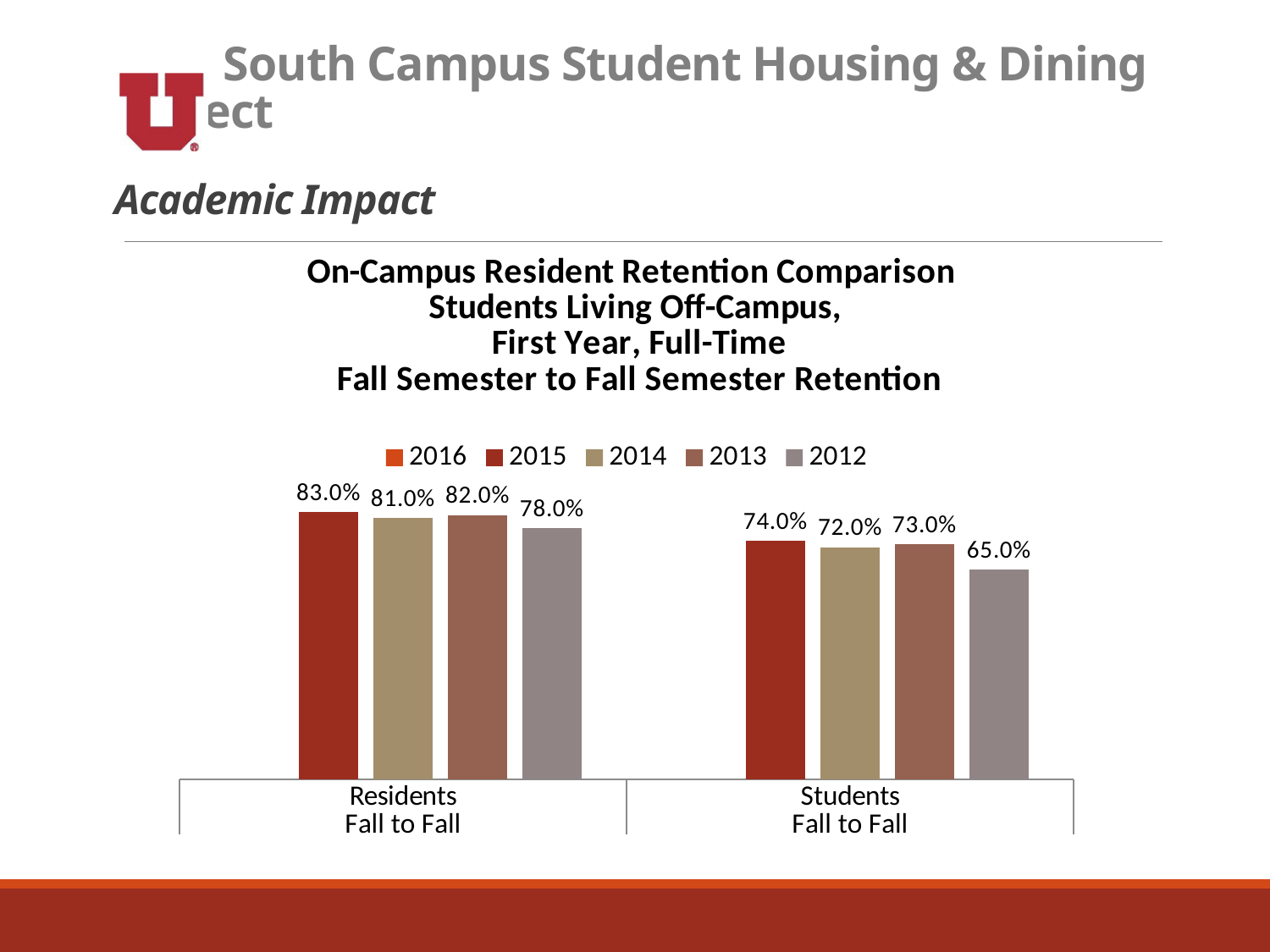
Which year has the lowest retention value in the Students Fall to Fall group? 2012 What is the 2013 retention value for Residents Fall to Fall? 82.0% Which year has the highest retention value in the Residents Fall to Fall group? 2015 Which is larger, the 2014 value for Residents Fall to Fall or the 2013 value for Students Fall to Fall? 2014 value for Residents Fall to Fall What is the 2015 retention value for Residents Fall to Fall? 83.0% What kind of chart is shown on the slide? Bar chart What is the 2014 retention value for Students Fall to Fall? 72.0% How many category groups are shown on the x axis? 2 What is the 2012 retention value for Students Fall to Fall? 65.0% How many series does the legend list? 5 What is the difference between the 2012 values for Residents Fall to Fall and Students Fall to Fall? 13.0% What is the difference between the 2015 values for Residents Fall to Fall and Students Fall to Fall? 9.0%